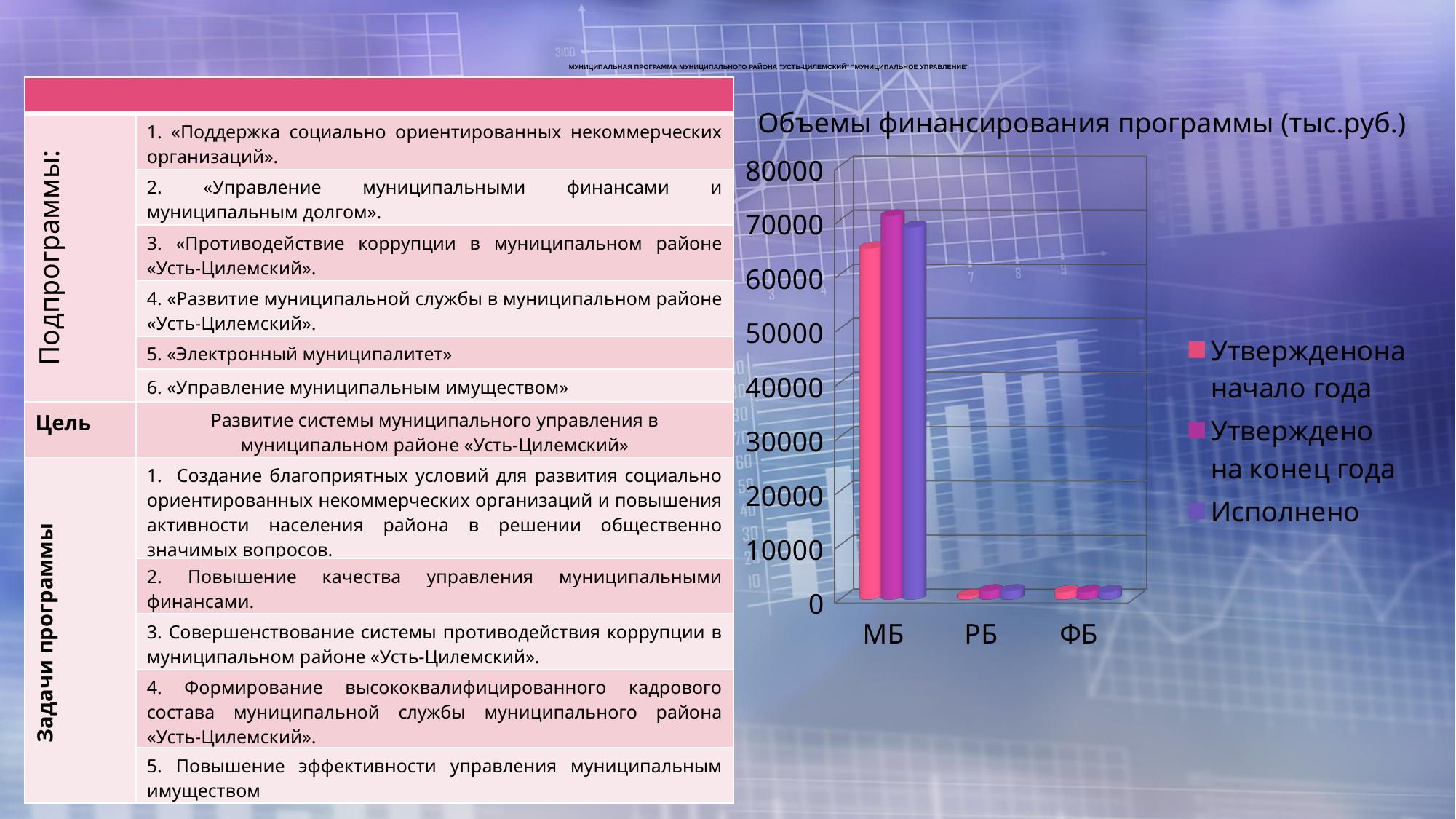
Is the value for ФБ in the series 'Утверждено на конец года' greater or less than 10000? less In the series 'Исполнено', which is larger: МБ or ФБ? МБ Is the value for МБ in the series 'Утвержденона начало года' greater or less than 70000? less Is the value for РБ in the series 'Исполнено' greater or less than 10000? less How many series does the chart legend list? 3 What kind of chart is shown on the slide? bar chart Which category has the highest values in the chart? МБ For МБ, which is larger: 'Утвержденона начало года' or 'Утверждено на конец года'? Утверждено на конец года How many categories are shown on the x axis of the chart? 3 What is the title of the chart? Объемы финансирования программы (тыс.руб.)